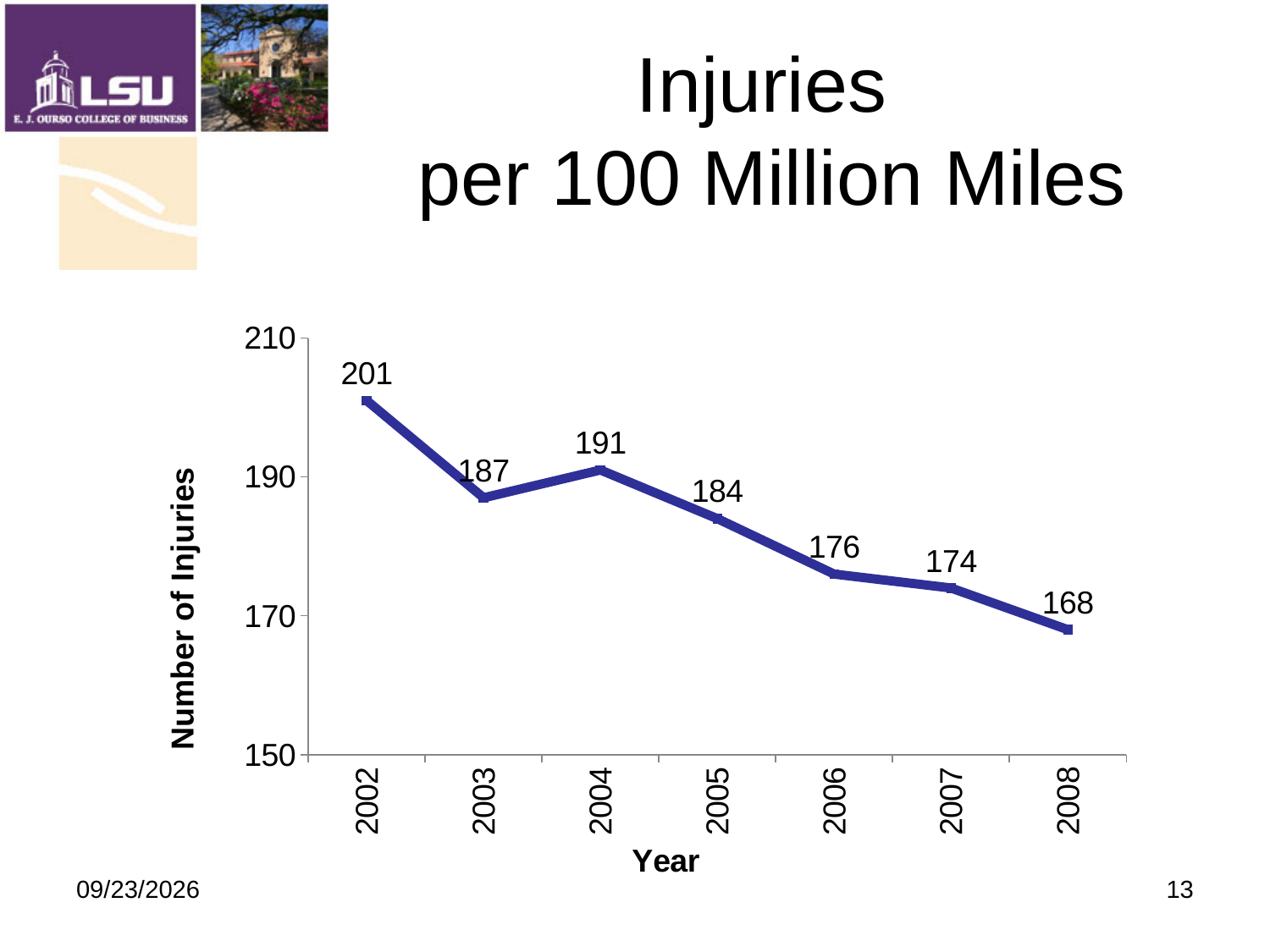
What is the number of injuries per 100 million miles in 2002? 201 What is the difference in the number of injuries between 2003 and 2004? 4 What kind of chart is shown on the slide? Line chart What is the number of injuries per 100 million miles in 2005? 184 What is the number of injuries per 100 million miles in 2008? 168 What is the label of the y axis? Number of Injuries How many years are plotted on the chart? 7 Do the number of injuries generally rise or fall from 2002 to 2008? Fall What is the difference in the number of injuries between 2002 and 2008? 33 Which year has the highest number of injuries? 2002 Which year has the lowest number of injuries? 2008 Which year has more injuries, 2004 or 2006? 2004